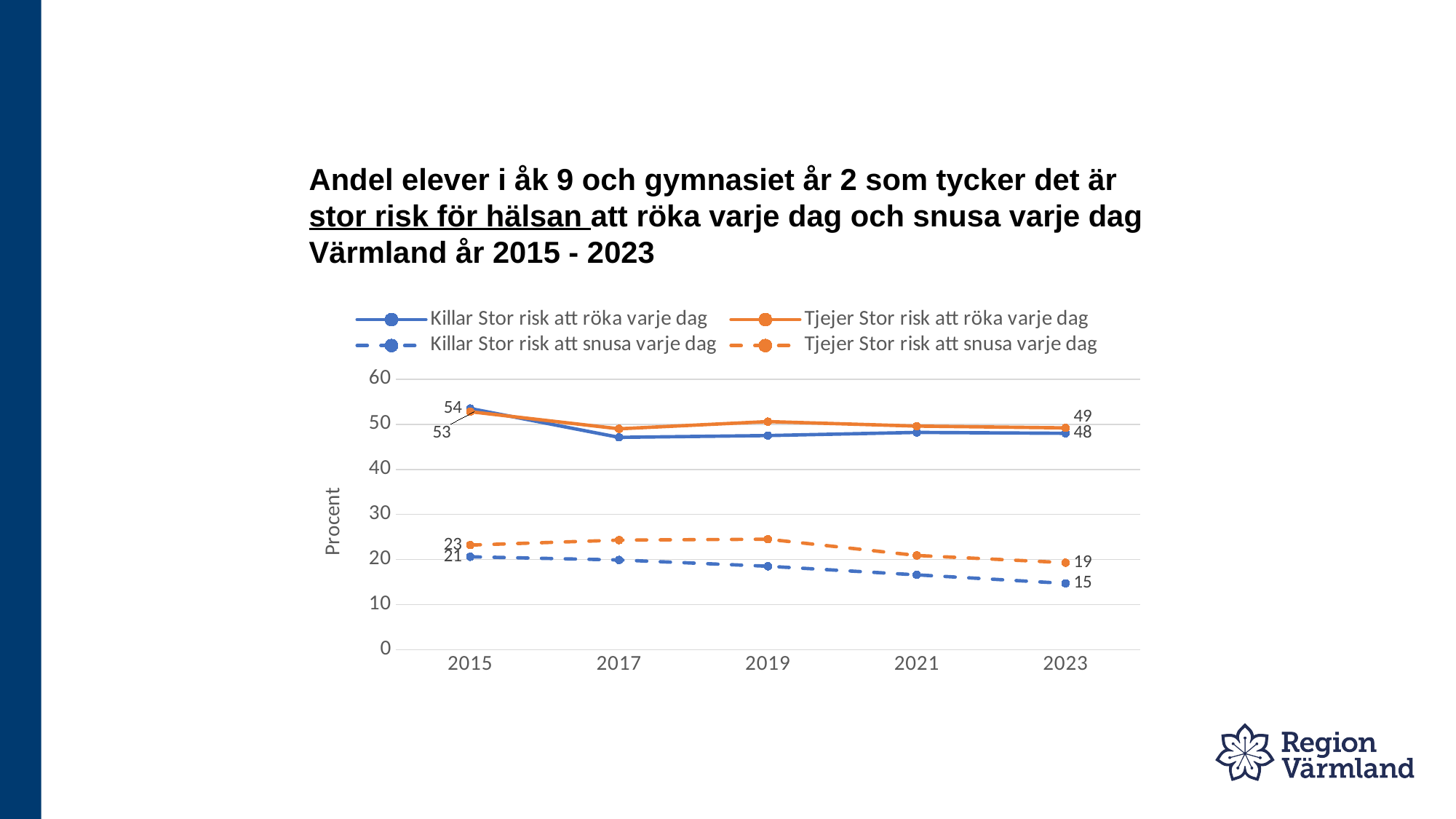
What is the value for 'Killar Stor risk att snusa varje dag' in 2023? 15 What kind of chart is shown on the slide? line chart Is the value for 'Tjejer Stor risk att snusa varje dag' in 2019 greater or less than 30? less Which is larger in 2023: 'Tjejer Stor risk att snusa varje dag' or 'Killar Stor risk att snusa varje dag'? Tjejer Stor risk att snusa varje dag How many series does the legend list? 4 Does 'Killar Stor risk att snusa varje dag' rise or fall from 2015 to 2023? fall How many years are shown on the x axis? 5 What is the value for 'Tjejer Stor risk att snusa varje dag' in 2015? 23 What is the value for 'Killar Stor risk att röka varje dag' in 2015? 54 What is the difference between 'Killar Stor risk att snusa varje dag' in 2015 and in 2023? 6 What is the value for 'Tjejer Stor risk att röka varje dag' in 2023? 49 What is the label of the y axis? Procent